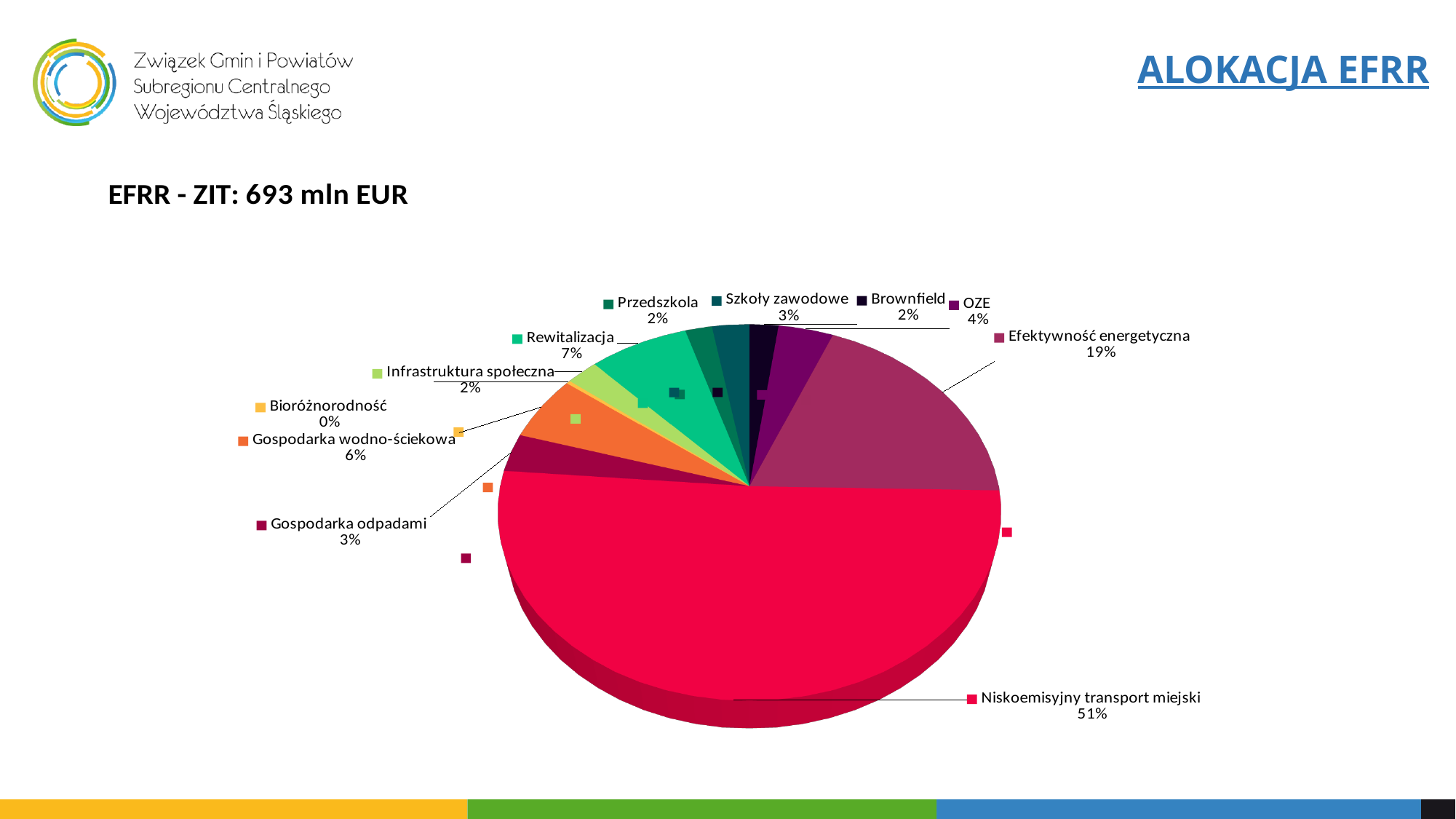
What kind of chart is shown on the slide? pie chart What is the difference in percentage points between Niskoemisyjny transport miejski and Efektywność energetyczna? 32 percentage points What share of the pie does Efektywność energetyczna have? 19% What is the value shown for OZE? 4% What total allocation is stated in the heading above the chart? 693 mln EUR What is the value shown for Rewitalizacja? 7% What is the value shown for Gospodarka wodno-ściekowa? 6% Which category has the smallest slice of the pie? Bioróżnorodność Which is larger, the share for Rewitalizacja or the share for Gospodarka wodno-ściekowa? Rewitalizacja Which category has the largest slice of the pie? Niskoemisyjny transport miejski What share of the pie does Niskoemisyjny transport miejski have? 51% How many categories are shown in the pie chart? 11